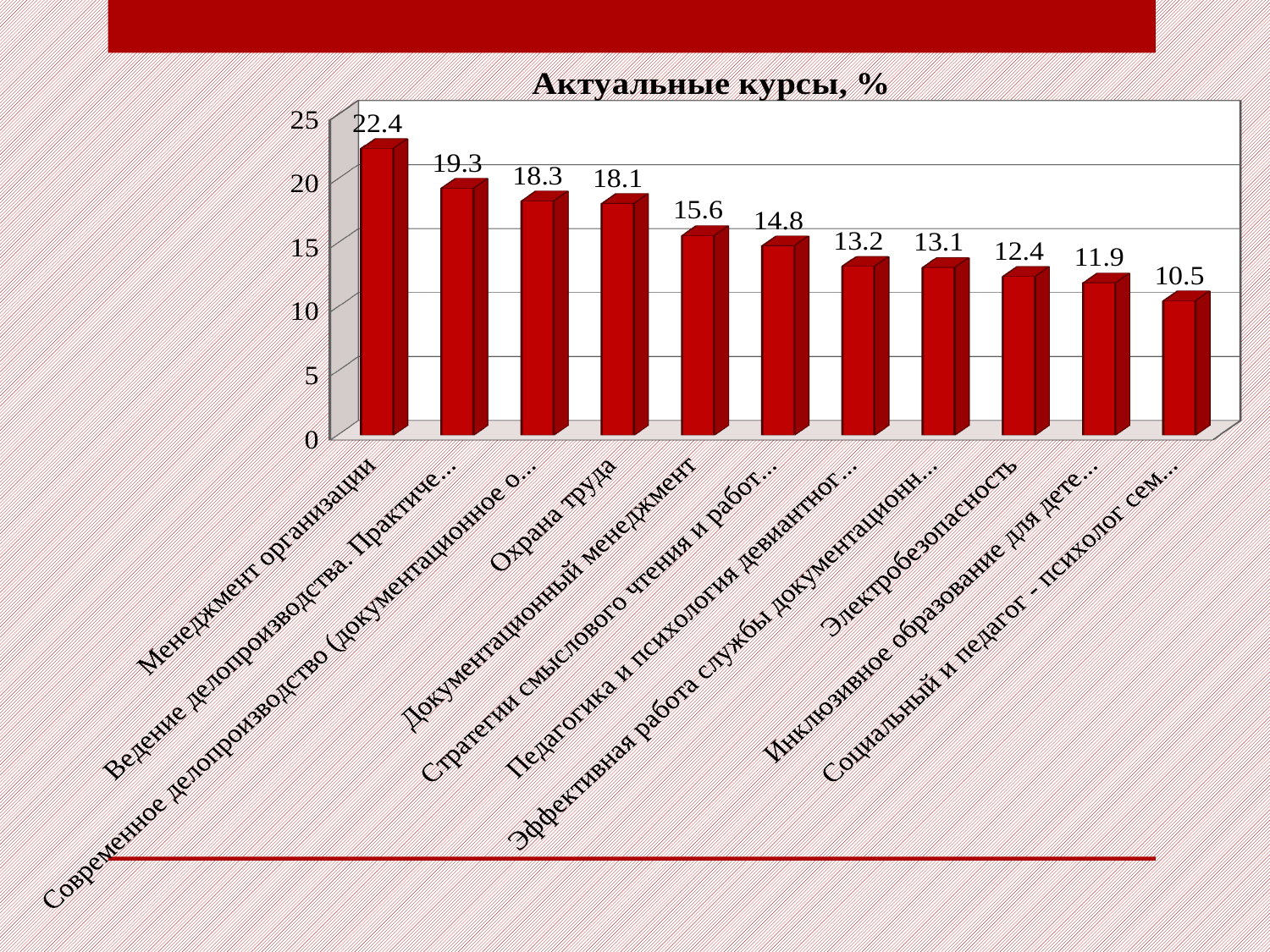
What is the value for Электробезопасность? 12.4 Which is larger, the value for Документационный менеджмент or the value for Электробезопасность? Документационный менеджмент What is the value for Документационный менеджмент? 15.6 What is the value for Охрана труда? 18.1 What is the value for Менеджмент организации? 22.4 What is the difference between the values for Менеджмент организации and Охрана труда? 4.3 What is the title of the chart? Актуальные курсы, % How many bars are shown on the chart? 11 What is the lowest value shown on the chart? 10.5 Which category has the highest value? Менеджмент организации What kind of chart is shown on the slide? bar chart Is the value for Электробезопасность greater or less than 15? less